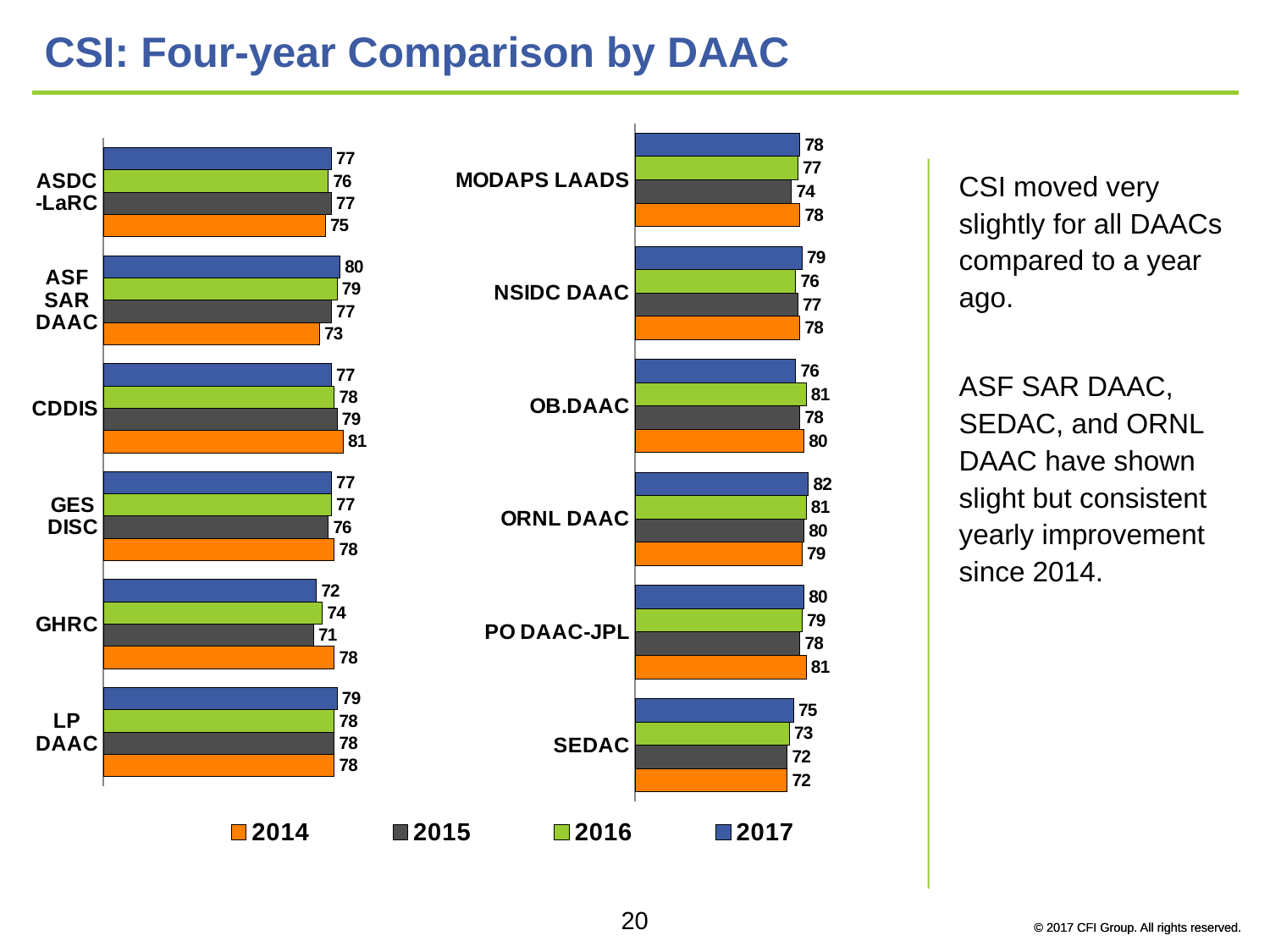
In the left chart, what is the 2017 value for ASF SAR DAAC? 80 In the right chart, which is larger for OB.DAAC: the 2016 value or the 2017 value? 2016 Which colour represents 2014 in the legend? Orange What kind of chart is used on this slide? Bar chart How many DAACs are shown in the right chart? 6 In the right chart, which DAAC has the highest 2017 value? ORNL DAAC In the left chart, which DAAC has the lowest 2014 value? ASF SAR DAAC How many series does the legend list? 4 In the right chart, what is the 2014 value for SEDAC? 72 In the left chart, what is the difference between the 2014 and 2017 values for GHRC? 6 In the left chart, do the values for CDDIS rise or fall from 2014 to 2017? Fall In the left chart, what is the 2015 value for GHRC? 71